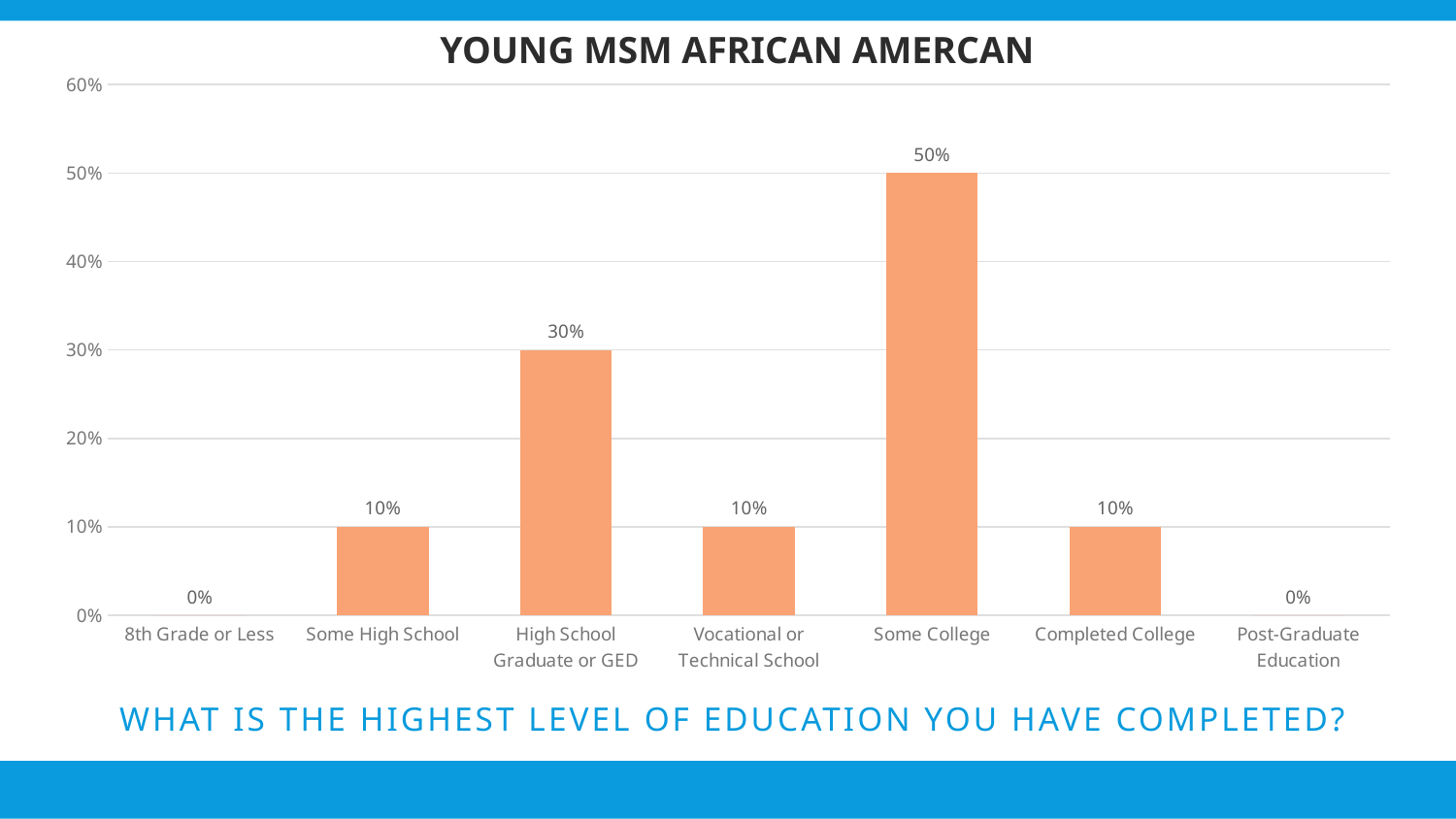
What is the difference between the values for Some College and High School Graduate or GED? 20% What is the value for Completed College? 10% What is the value for High School Graduate or GED? 30% What kind of chart is shown on the slide? Bar chart How many categories have a value of 10%? 3 What is the highest value shown on the y axis? 60% What is the title of the chart? YOUNG MSM AFRICAN AMERCAN What is the value for 8th Grade or Less? 0% What is the value for Some College? 50% Which is larger, the value for Some High School or the value for High School Graduate or GED? High School Graduate or GED How many categories are shown on the x axis? 7 Which category has the highest value? Some College